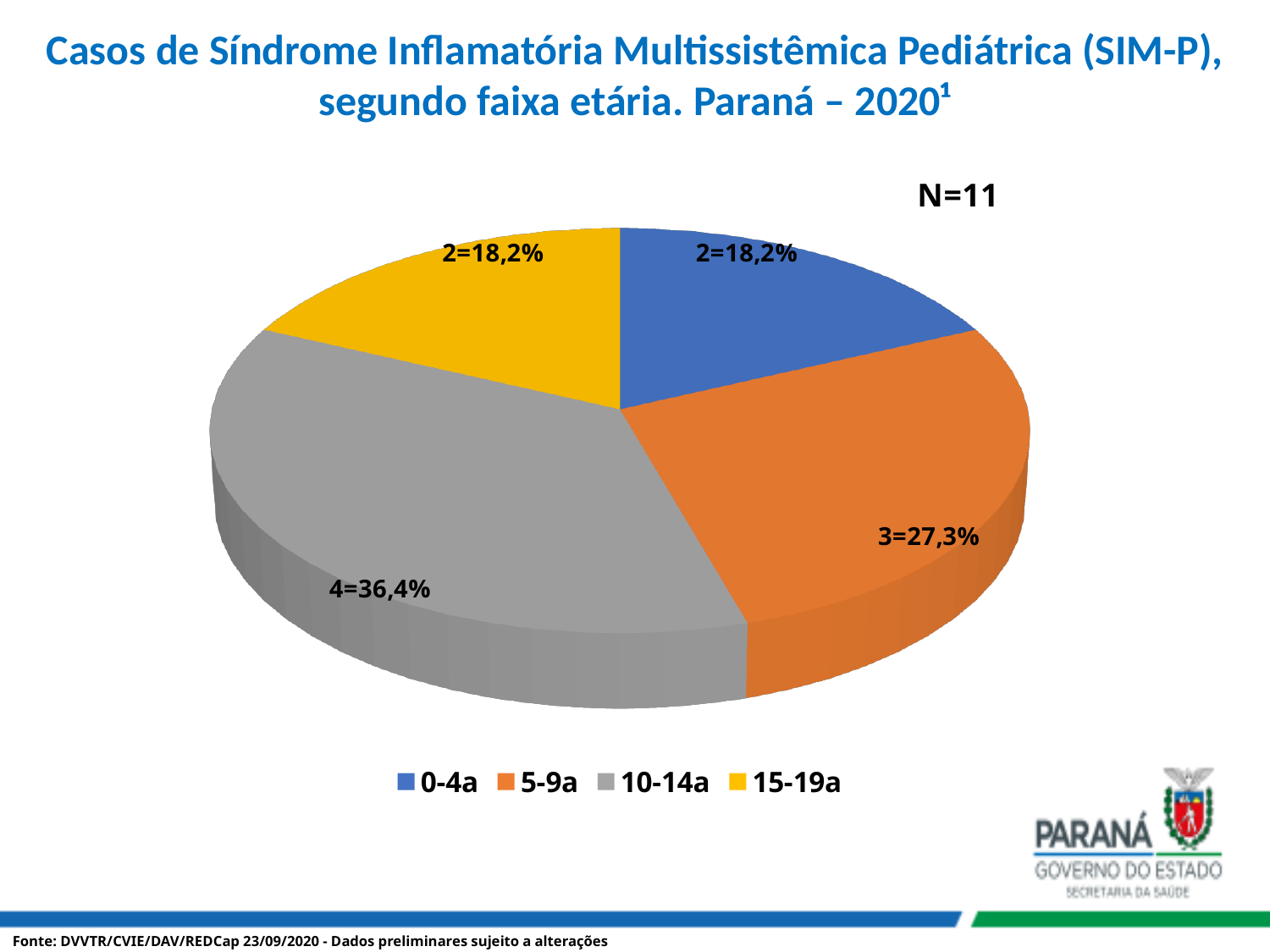
How many age groups (slices) does the pie chart show? 4 What is the data label for the 5-9a slice? 3=27,3% What is the data label for the 10-14a slice? 4=36,4% What percentage share of the pie does the 0-4a age group have? 18,2% How many entries does the legend list? 4 Which age group has the largest share of cases? 10-14a What colour represents the 10-14a age group in the pie chart? Gray What is the difference in number of cases between the 10-14a and 5-9a age groups? 1 What kind of chart is shown on the slide? Pie chart How many cases are in the 15-19a age group? 2 Which age group has more cases, 5-9a or 15-19a? 5-9a What is the total number of cases (N) shown on the slide? 11